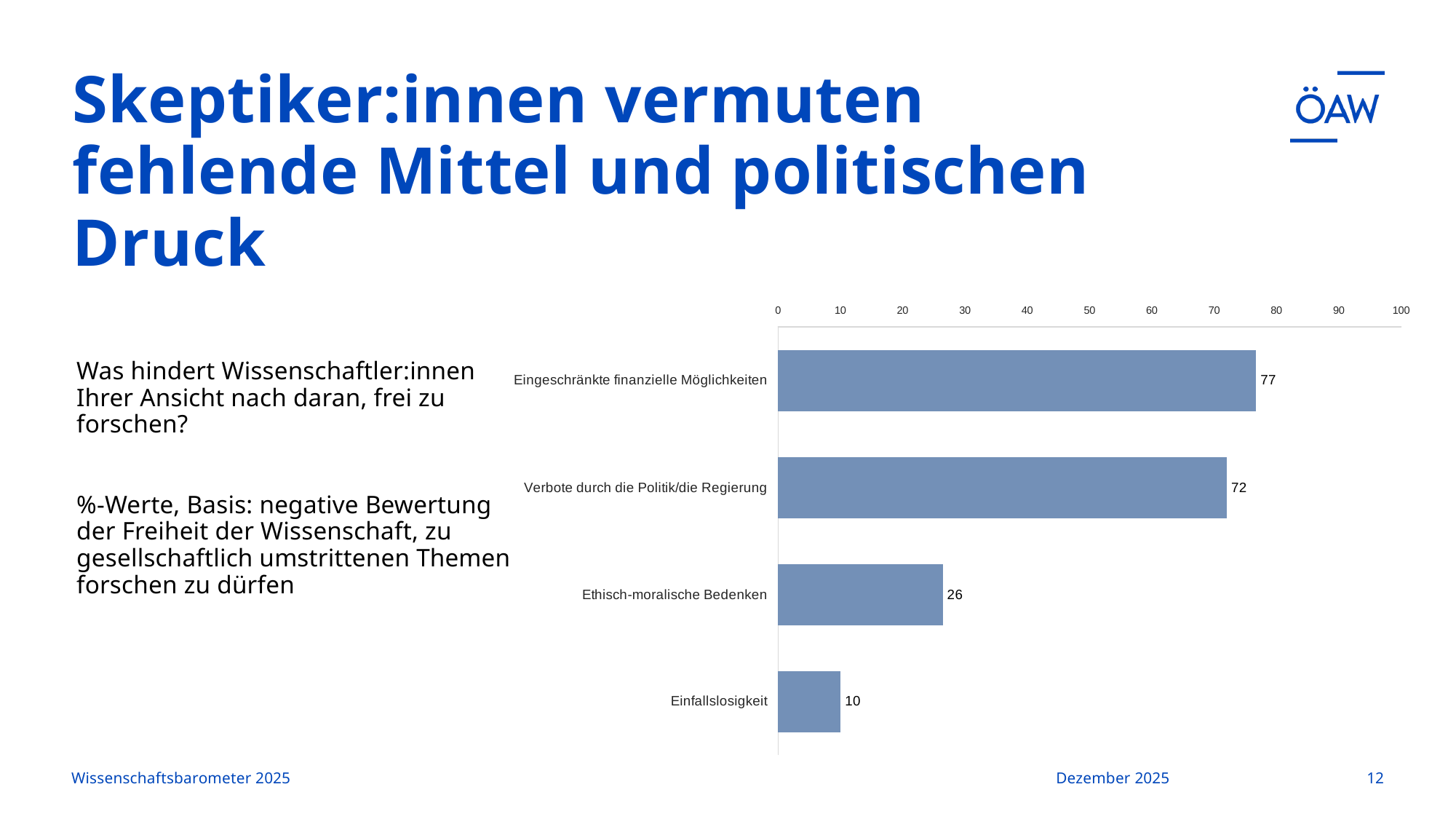
What is the value for "Einfallslosigkeit"? 10 What is the value for "Ethisch-moralische Bedenken"? 26 Which is larger, the value for "Verbote durch die Politik/die Regierung" or the value for "Ethisch-moralische Bedenken"? Verbote durch die Politik/die Regierung What is the value for "Eingeschränkte finanzielle Möglichkeiten"? 77 What kind of chart is shown on the slide? bar chart Which category has the highest value? Eingeschränkte finanzielle Möglichkeiten How many categories are shown in the chart? 4 Is the value for "Ethisch-moralische Bedenken" greater or less than 30? less What is the value for "Verbote durch die Politik/die Regierung"? 72 What is the difference between the values for "Eingeschränkte finanzielle Möglichkeiten" and "Verbote durch die Politik/die Regierung"? 5 Which category has the lowest value? Einfallslosigkeit What is the difference between the values for "Ethisch-moralische Bedenken" and "Einfallslosigkeit"? 16